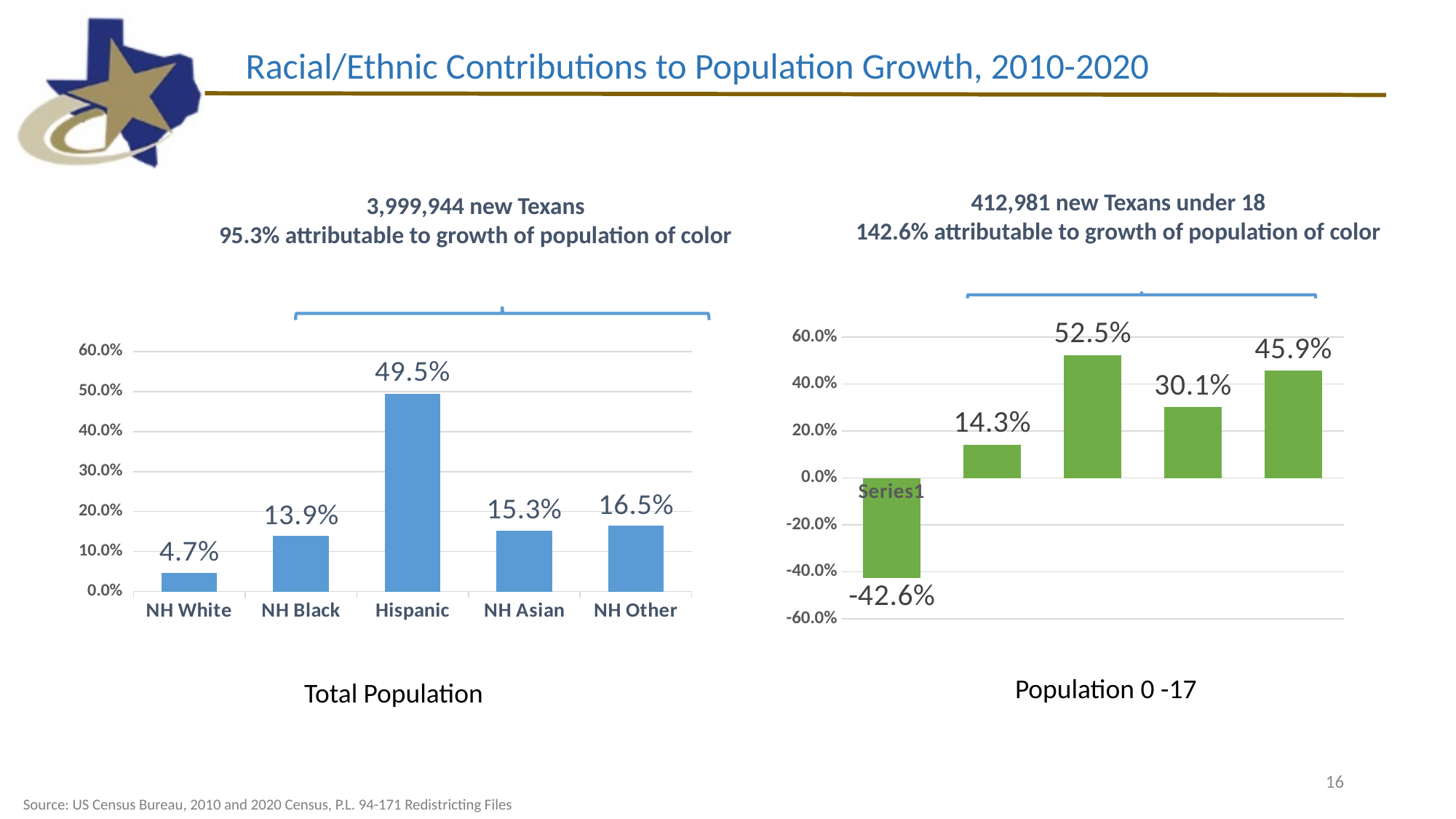
In the Total Population chart, which category has the highest value? Hispanic What is the title of the slide? Racial/Ethnic Contributions to Population Growth, 2010-2020 In the Total Population chart, what is the difference between the values for NH Other and NH Black? 2.6% In the Total Population chart, what is the value for NH Asian? 15.3% In the Population 0-17 chart, what is the highest value shown? 52.5% In the Total Population chart, what is the value for Hispanic? 49.5% In the Total Population chart, which category has the lowest value? NH White What kind of chart is the Population 0-17 chart? Bar chart How many categories are shown in the Total Population chart? 5 In the Total Population chart, which is larger, the value for NH Asian or the value for NH Black? NH Asian In the Total Population chart, what is the value for NH White? 4.7% In the Population 0-17 chart, what is the value of the first bar from the left? -42.6%